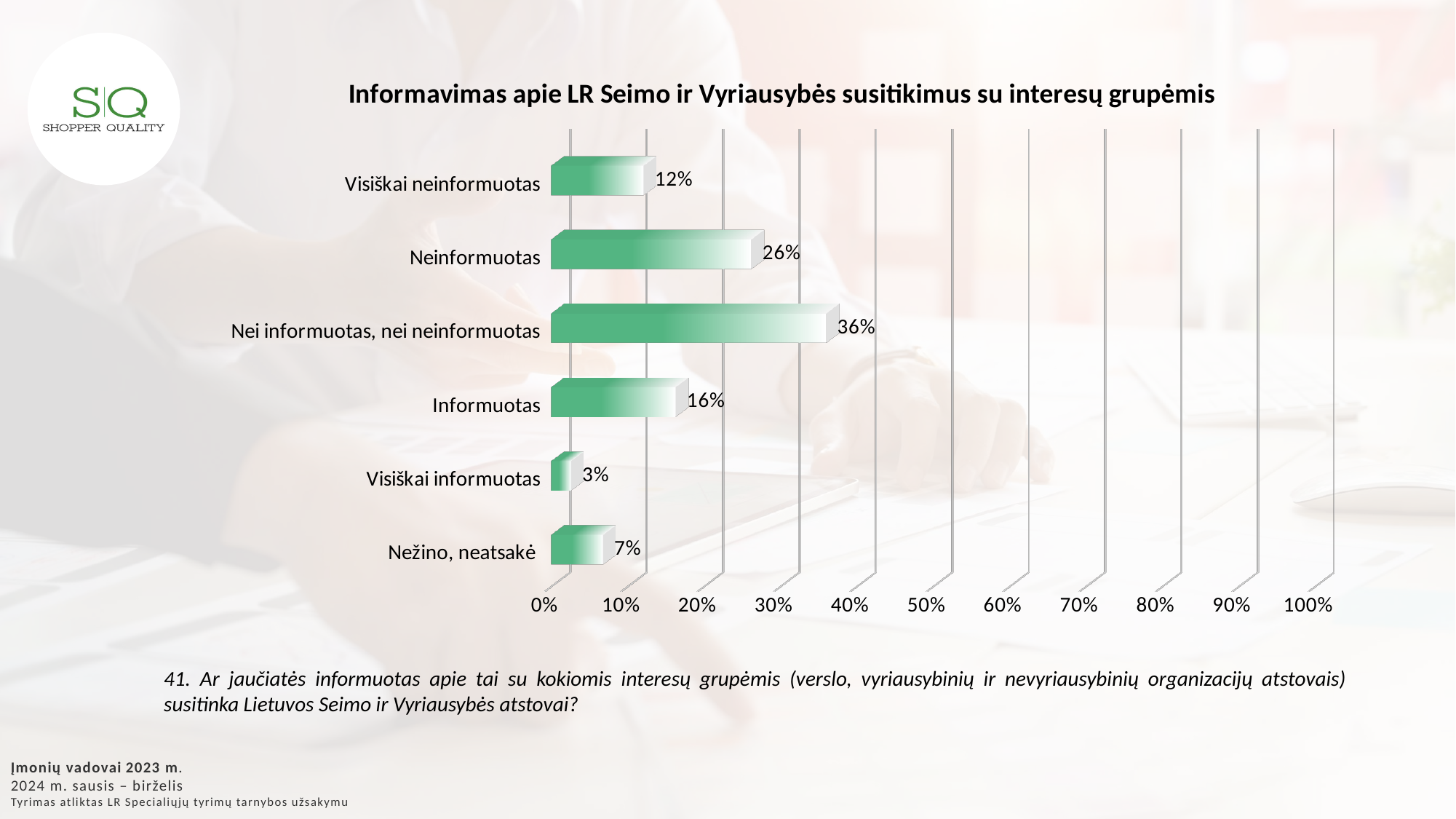
What is the value for "Nežino, neatsakė"? 7% Is the value for "Nei informuotas, nei neinformuotas" greater or less than 30%? greater Which is larger, the value for "Informuotas" or the value for "Visiškai neinformuotas"? Informuotas Which category has the highest value? Nei informuotas, nei neinformuotas How many categories are shown in the chart? 6 What is the value for "Nei informuotas, nei neinformuotas"? 36% What is the difference between the values for "Neinformuotas" and "Visiškai neinformuotas"? 14% What kind of chart is shown on the slide? bar chart What is the value for "Neinformuotas"? 26% What is the value for "Visiškai informuotas"? 3% What is the title of the chart? Informavimas apie LR Seimo ir Vyriausybės susitikimus su interesų grupėmis Which category has the lowest value? Visiškai informuotas